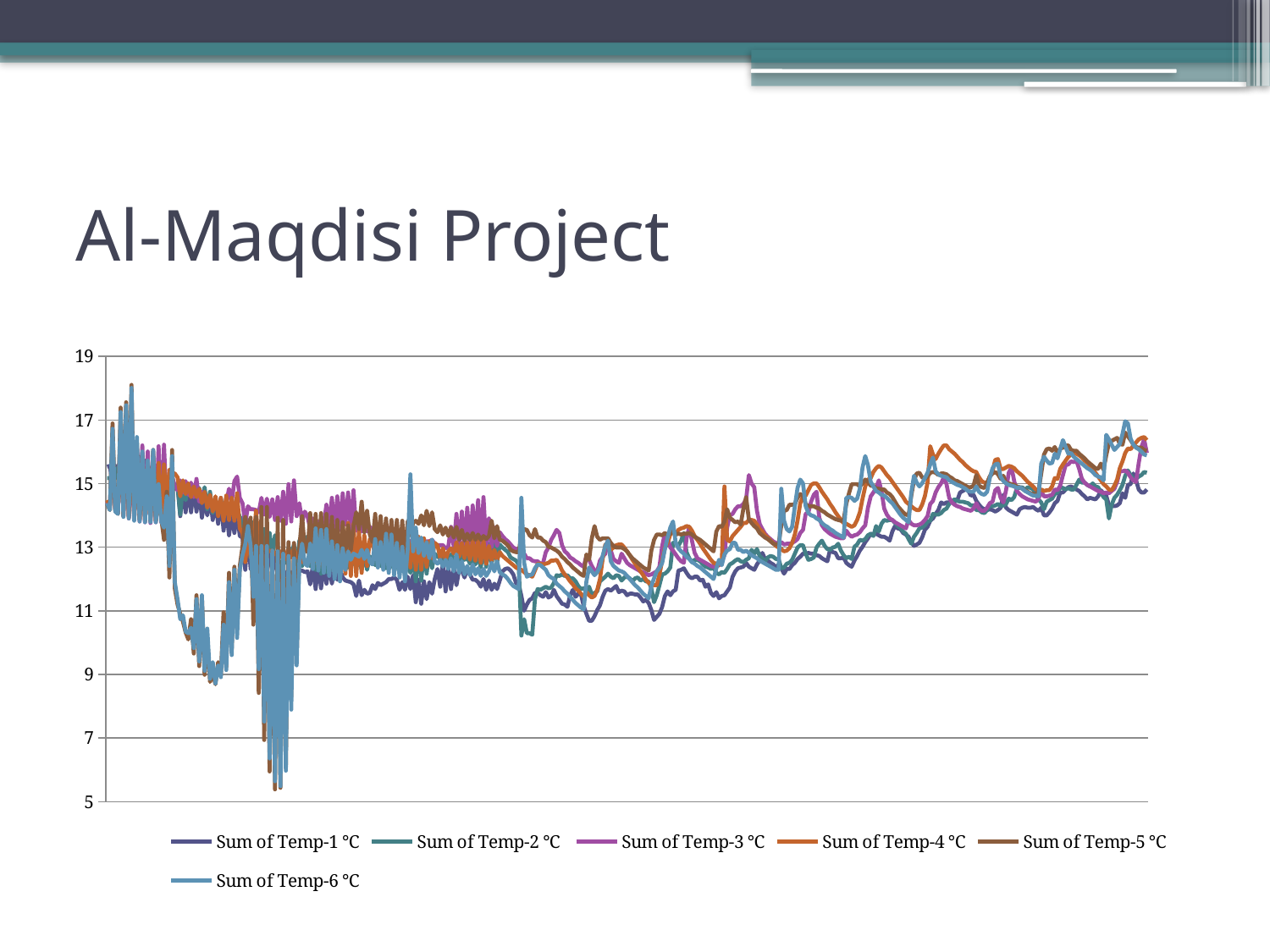
At the right end of the chart, are the values of the series greater or less than 13? greater In the middle section of the chart, is the value of Sum of Temp-1 °C greater or less than 13? less Is the lowest point reached by Sum of Temp-6 °C greater or less than 9? less What kind of chart is shown on the slide? line chart What is the title of the slide containing the chart? Al-Maqdisi Project From the middle of the chart to its right end, do the values generally rise or fall? rise What is the last entry in the chart's legend? Sum of Temp-6 °C How many tick labels are shown on the vertical axis? 8 How many series does the legend list? 6